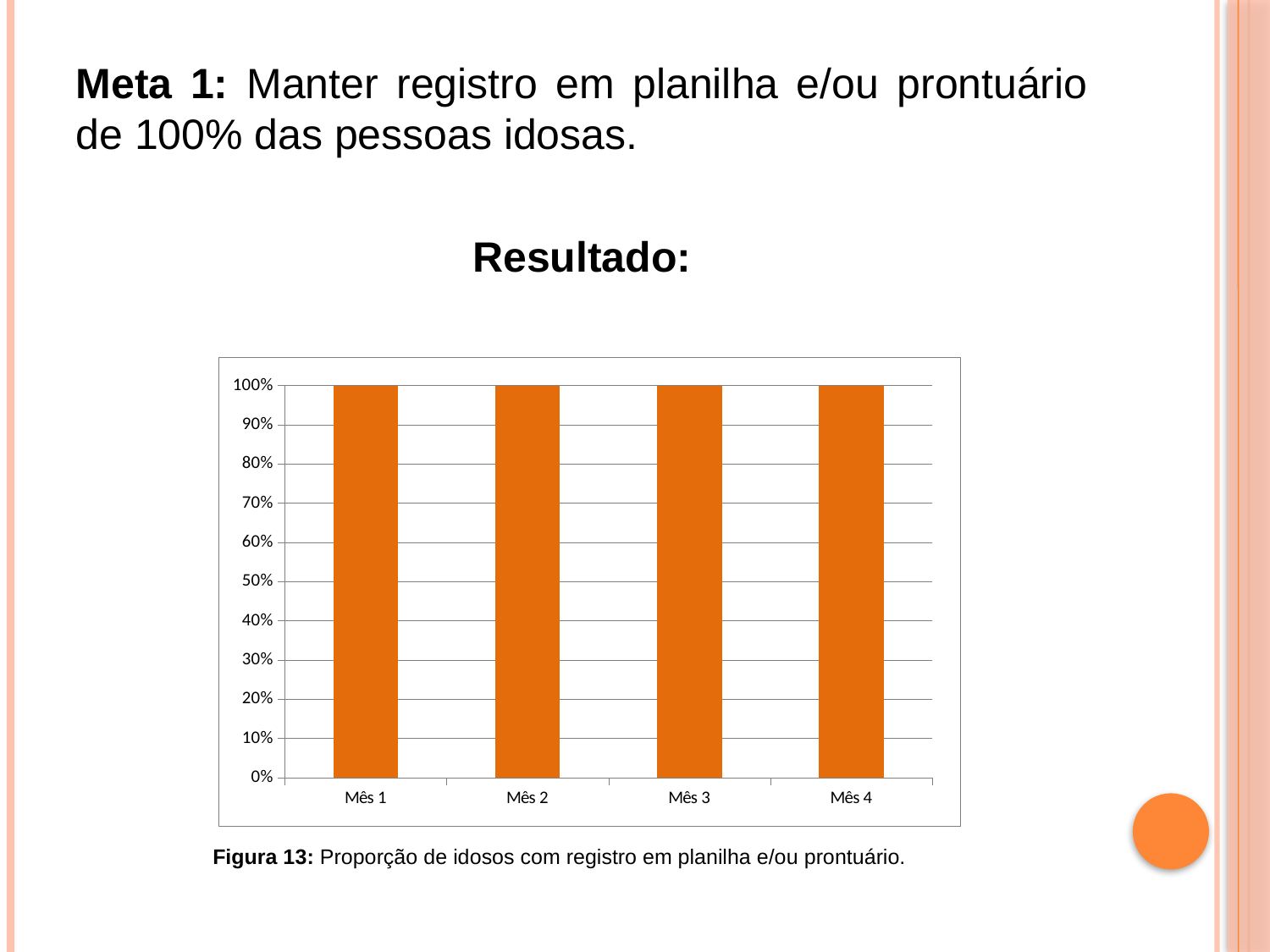
What is the value for Mês 4 in the chart? 100% Is the value for Mês 4 greater or less than 50%? greater How many categories (months) are shown on the x axis of the chart? 4 What is the label of the first category on the x axis of the chart? Mês 1 What is the difference between the values for Mês 1 and Mês 4? 0% Is the value for Mês 2 greater or less than 90%? greater What type of chart is shown on the slide? bar chart What is the value for Mês 2 in the chart? 100% What is the value for Mês 1 in the chart? 100% What is the value for Mês 3 in the chart? 100% What is the figure caption given below the chart? Figura 13: Proporção de idosos com registro em planilha e/ou prontuário. Do the values rise, fall, or stay the same from Mês 1 to Mês 4? stay the same